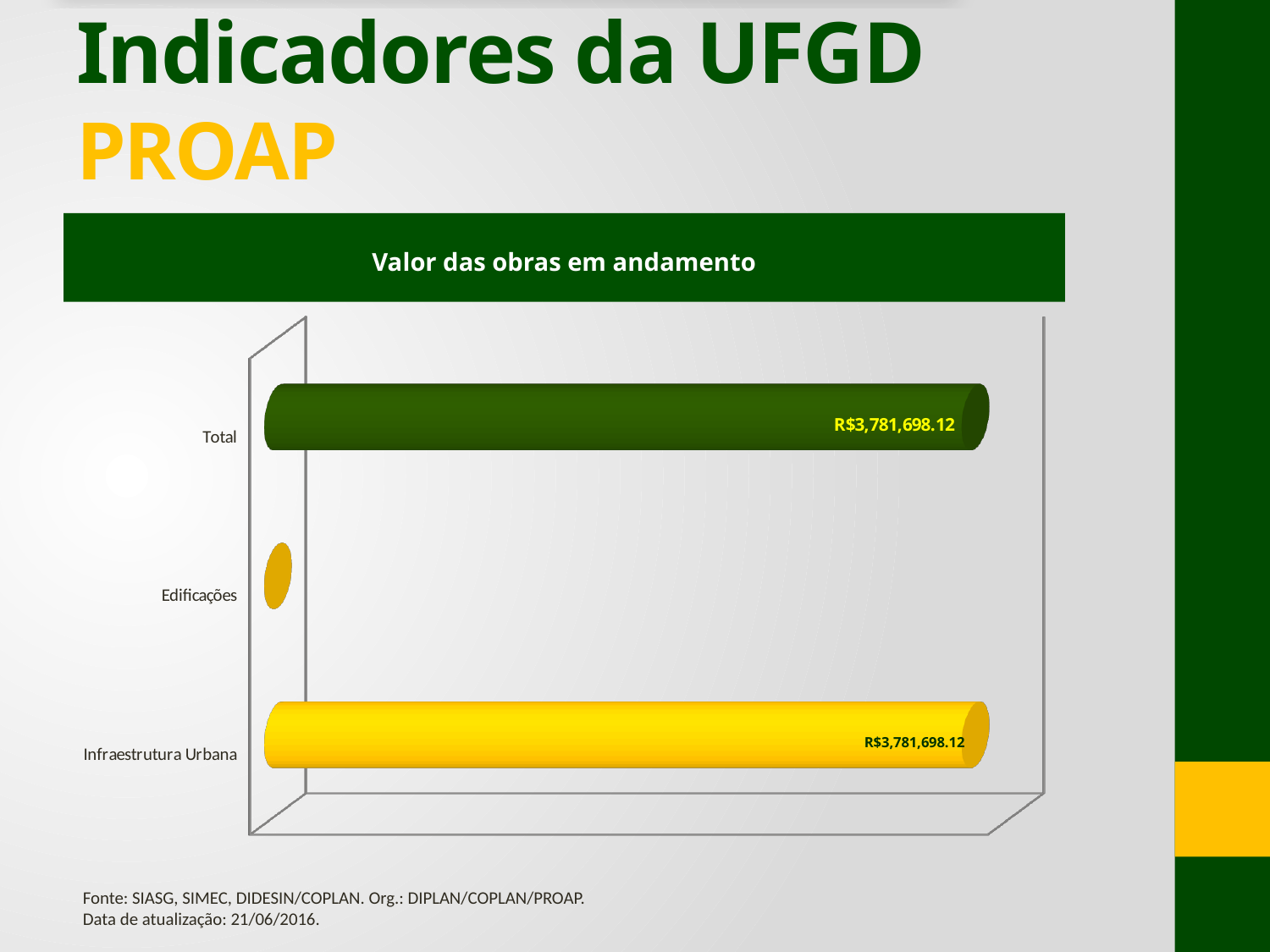
What is the value for Total in the chart? R$3,781,698.12 What kind of chart is shown on the slide? Bar chart Which is larger, the value for Infraestrutura Urbana or the value for Edificações? Infraestrutura Urbana What is the title of the chart? Valor das obras em andamento Which category has the lowest value in the chart? Edificações What colour is the bar for Infraestrutura Urbana? Yellow What is the value for Infraestrutura Urbana in the chart? R$3,781,698.12 How many categories are shown in the chart? 3 Which is larger, the value for Total or the value for Edificações? Total